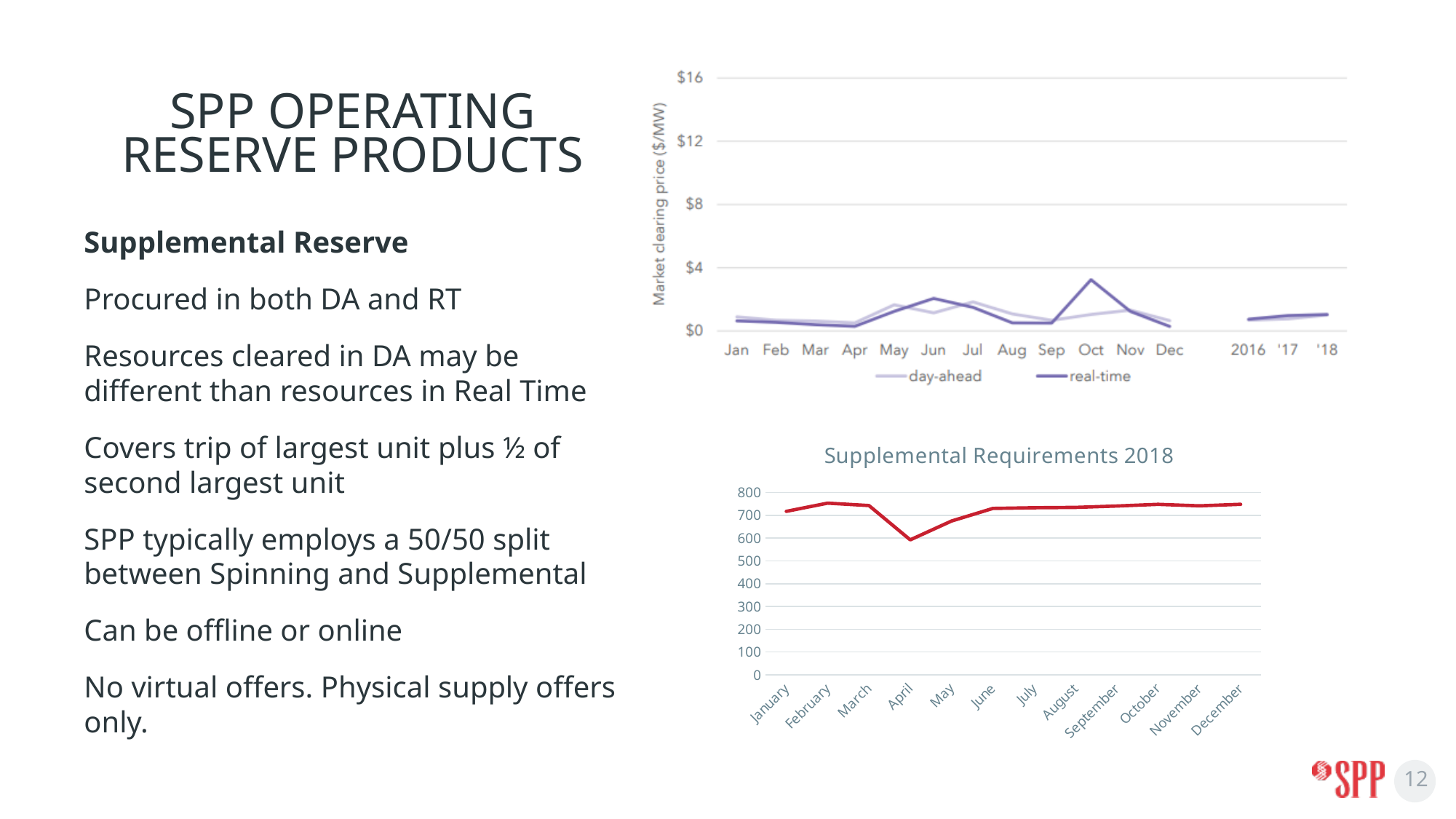
In the top chart (market clearing price), is the real-time value for Oct greater or less than $4? less What is the y-axis label of the top chart? Market clearing price ($/MW) In the 'Supplemental Requirements 2018' chart, which is larger, the value for April or the value for June? June In the top chart (market clearing price), how many series does the legend list? 2 What kind of chart is the 'Supplemental Requirements 2018' chart? line chart In the top chart (market clearing price), what are the two series named in the legend? day-ahead and real-time In the 'Supplemental Requirements 2018' chart, how many months are plotted along the x axis? 12 In the 'Supplemental Requirements 2018' chart, which month has the lowest value? April In the top chart (market clearing price), in which month does the real-time series reach its highest value? Oct In the 'Supplemental Requirements 2018' chart, does the line rise or fall from March to April? fall In the 'Supplemental Requirements 2018' chart, is the value for January greater or less than 800? less In the 'Supplemental Requirements 2018' chart, is the value for April greater or less than 500? greater